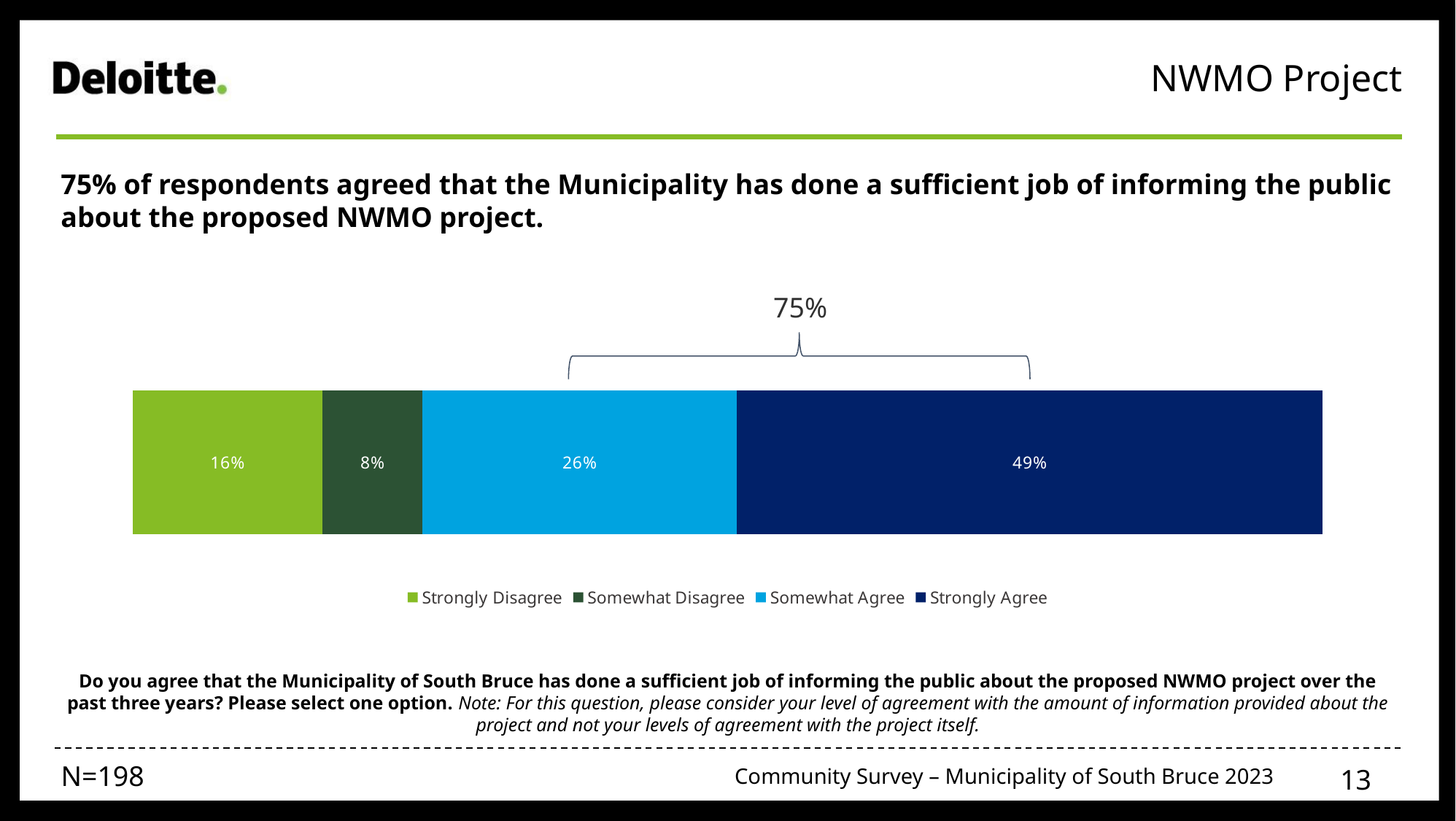
What percentage of respondents selected Strongly Disagree? 16% What kind of chart is shown on the slide? Stacked bar chart Which legend entry is shown in light green? Strongly Disagree What percentage of respondents selected Strongly Agree? 49% What percentage of respondents selected Somewhat Disagree? 8% What is the difference between the Strongly Agree and Somewhat Agree percentages? 23% Which response category has the largest share? Strongly Agree What is the combined percentage of Somewhat Agree and Strongly Agree, as labelled by the bracket above the bar? 75% How many response categories does the legend list? 4 Which is larger, the Strongly Disagree share or the Somewhat Disagree share? Strongly Disagree Which response category has the smallest share? Somewhat Disagree What percentage of respondents selected Somewhat Agree? 26%